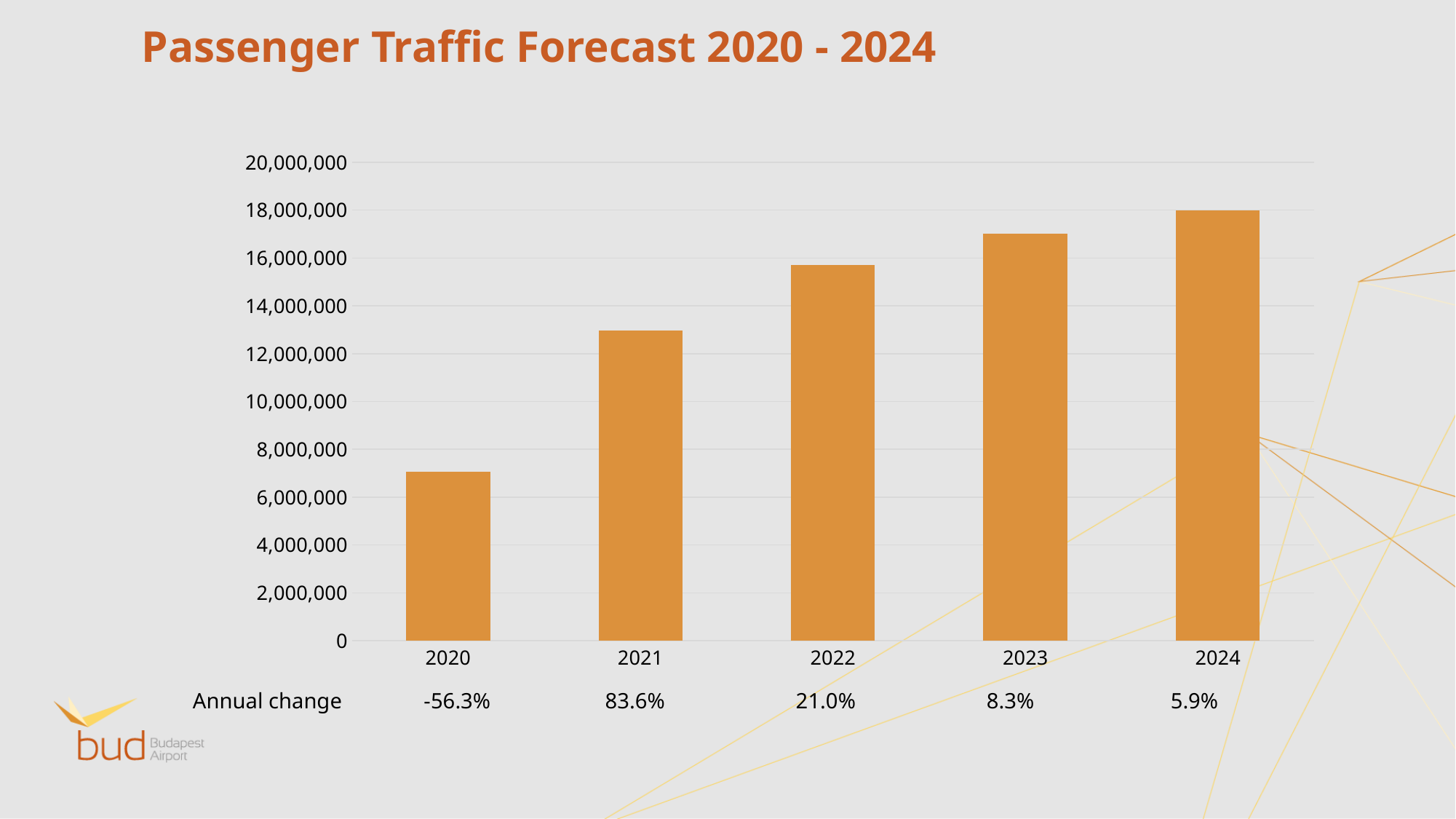
Is the value for 2020 greater or less than 8,000,000? less Which year has the lowest forecast passenger traffic? 2020 Do the passenger traffic values rise or fall from 2020 to 2024? rise Is the value for 2023 greater or less than 16,000,000? greater How many years are plotted on the chart? 5 What kind of chart is shown on the slide? bar chart Is the value for 2022 greater or less than 16,000,000? less What is the title of the chart? Passenger Traffic Forecast 2020 - 2024 What is the annual change shown for 2021? 83.6% Which year has the highest forecast passenger traffic? 2024 Which year has the larger forecast passenger traffic, 2021 or 2022? 2022